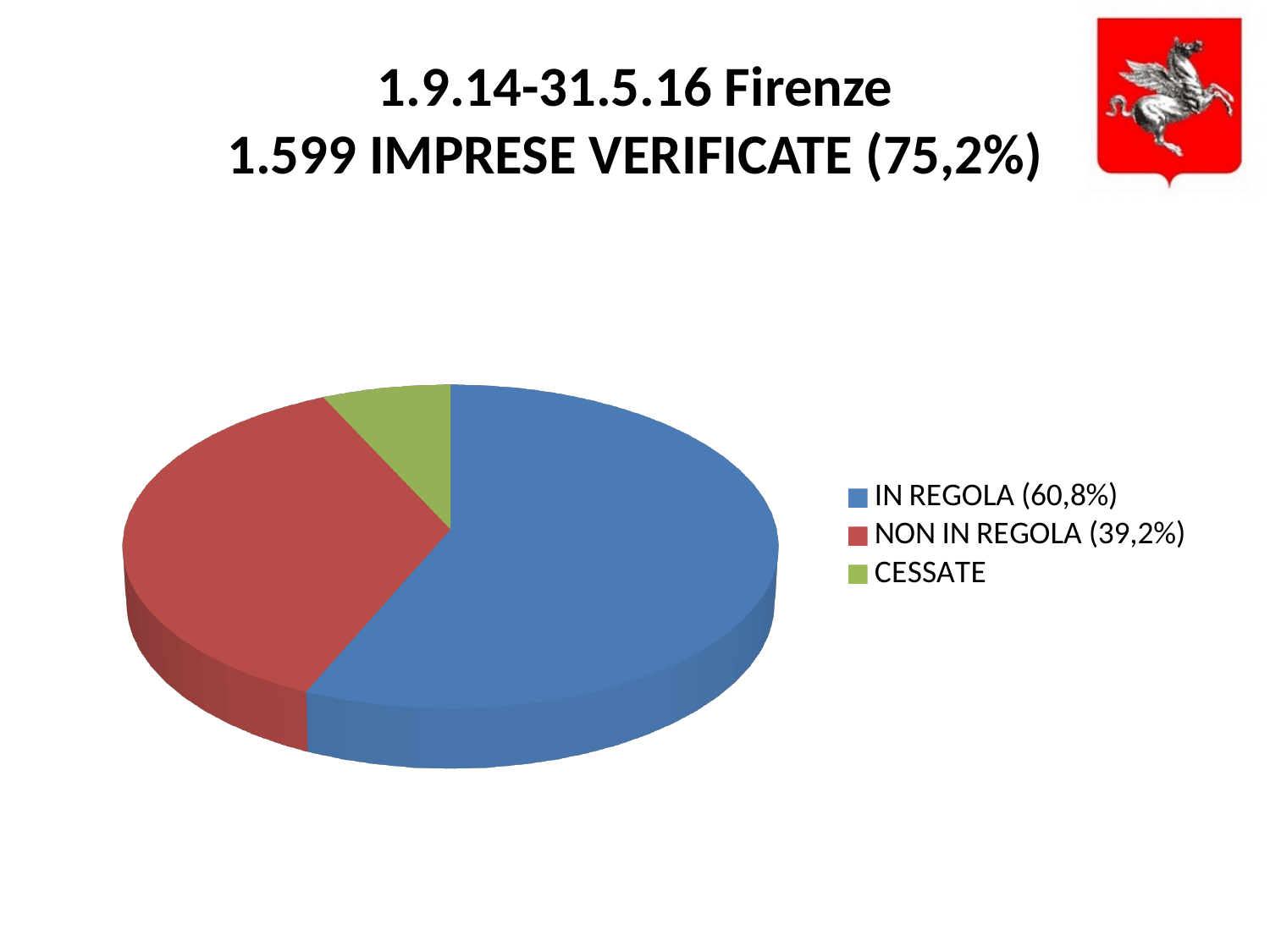
How many slices does the pie chart have? 3 What is the difference between the percentages shown for IN REGOLA and NON IN REGOLA? 21,6% What percentage is shown in the legend for IN REGOLA? 60,8% How many entries does the legend of the pie chart list? 3 Which slice is larger, NON IN REGOLA or CESSATE? NON IN REGOLA What percentage is shown in the legend for NON IN REGOLA? 39,2% Is the share shown for IN REGOLA greater or less than 50%? greater Which category has the smallest slice of the pie chart? CESSATE Which category has the largest slice of the pie chart? IN REGOLA What colour is the CESSATE slice of the pie chart? green What colour is the IN REGOLA slice of the pie chart? blue What kind of chart is shown on the slide? pie chart